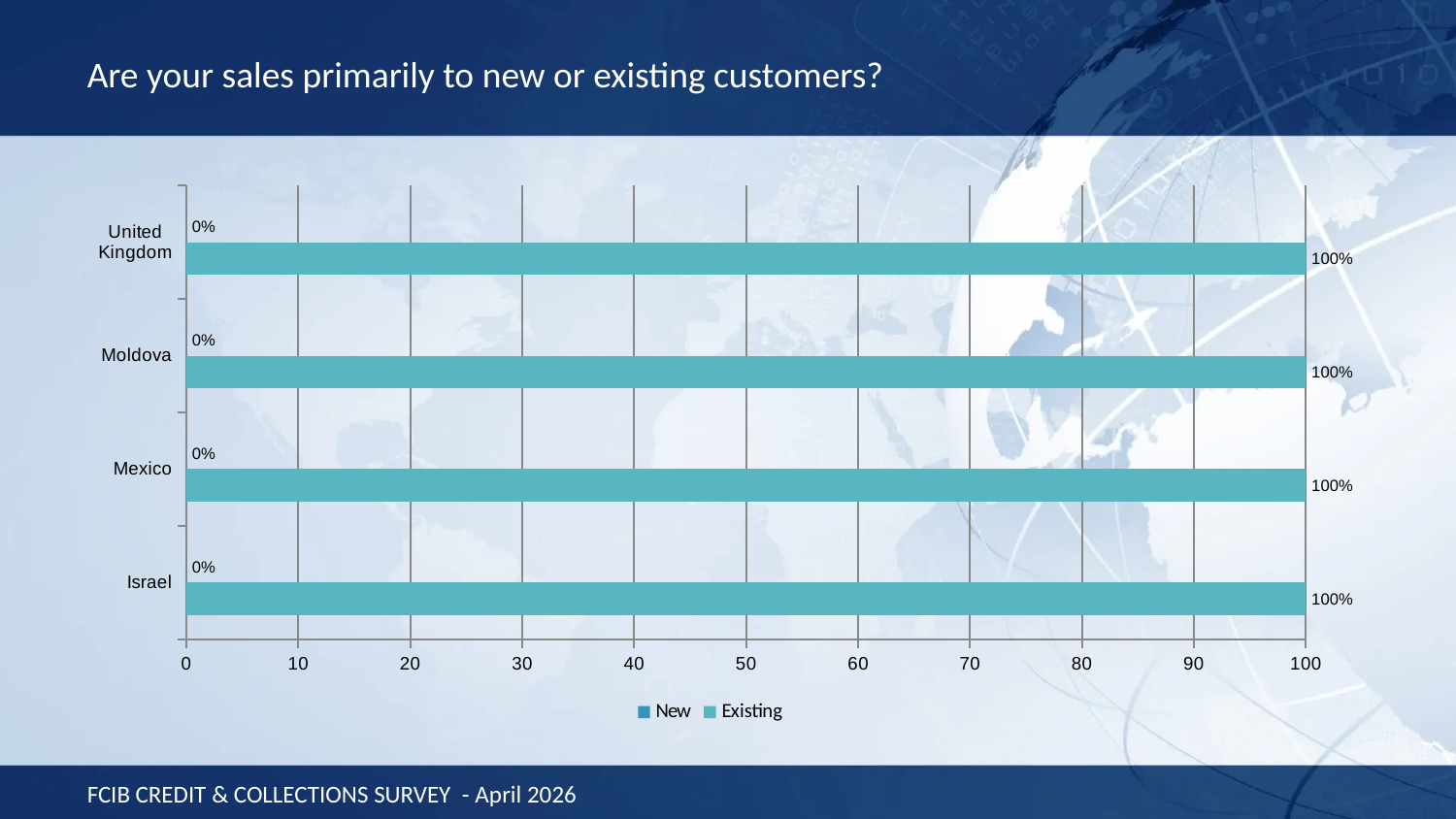
Is the Existing value for Mexico greater or less than 50? greater What is the value for Existing customers for the United Kingdom? 100% What is the difference between the Existing and New values for Israel? 100% How many series does the legend list? 2 What is the value for New customers for Moldova? 0% What are the two series listed in the legend? New and Existing What is the value for New customers for Israel? 0% What is the title of the chart on the slide? Are your sales primarily to new or existing customers? What is the value for Existing customers for Mexico? 100% How many countries are shown on the chart? 4 For Moldova, which is larger: the New value or the Existing value? Existing What kind of chart is shown on the slide? Bar chart